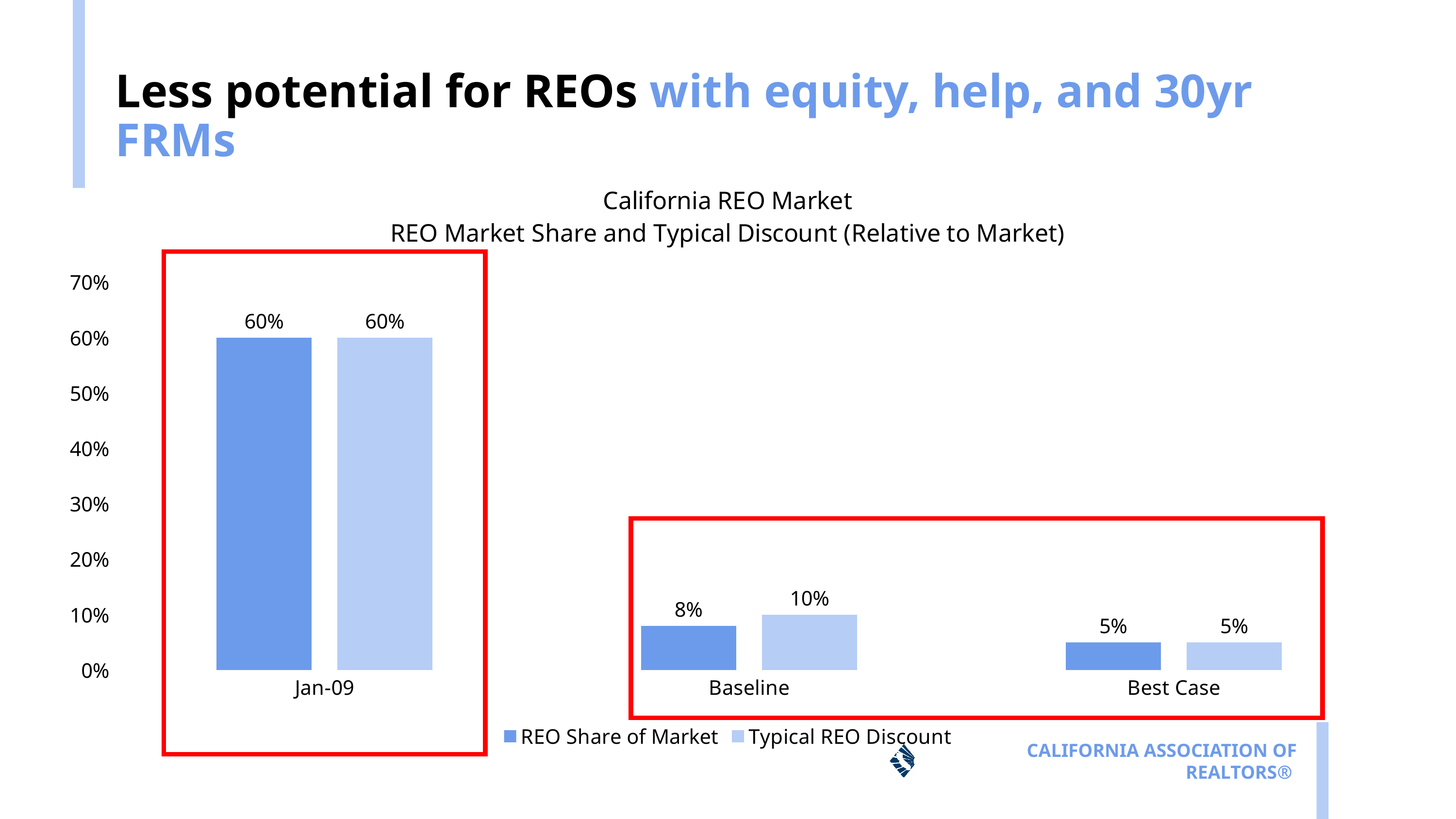
What is the difference between the REO Share of Market for Jan-09 and for Baseline? 52% What is the REO Share of Market for Jan-09? 60% What is the REO Share of Market for Baseline? 8% Which category has the highest REO Share of Market? Jan-09 Which is larger for Baseline: REO Share of Market or Typical REO Discount? Typical REO Discount How many categories are shown on the x axis? 3 What is the REO Share of Market for Best Case? 5% What kind of chart is shown on the slide? Bar chart What is the Typical REO Discount for Baseline? 10% How many series does the legend list? 2 Which category has the lowest Typical REO Discount? Best Case Does the REO Share of Market rise or fall from Jan-09 to Best Case? Fall